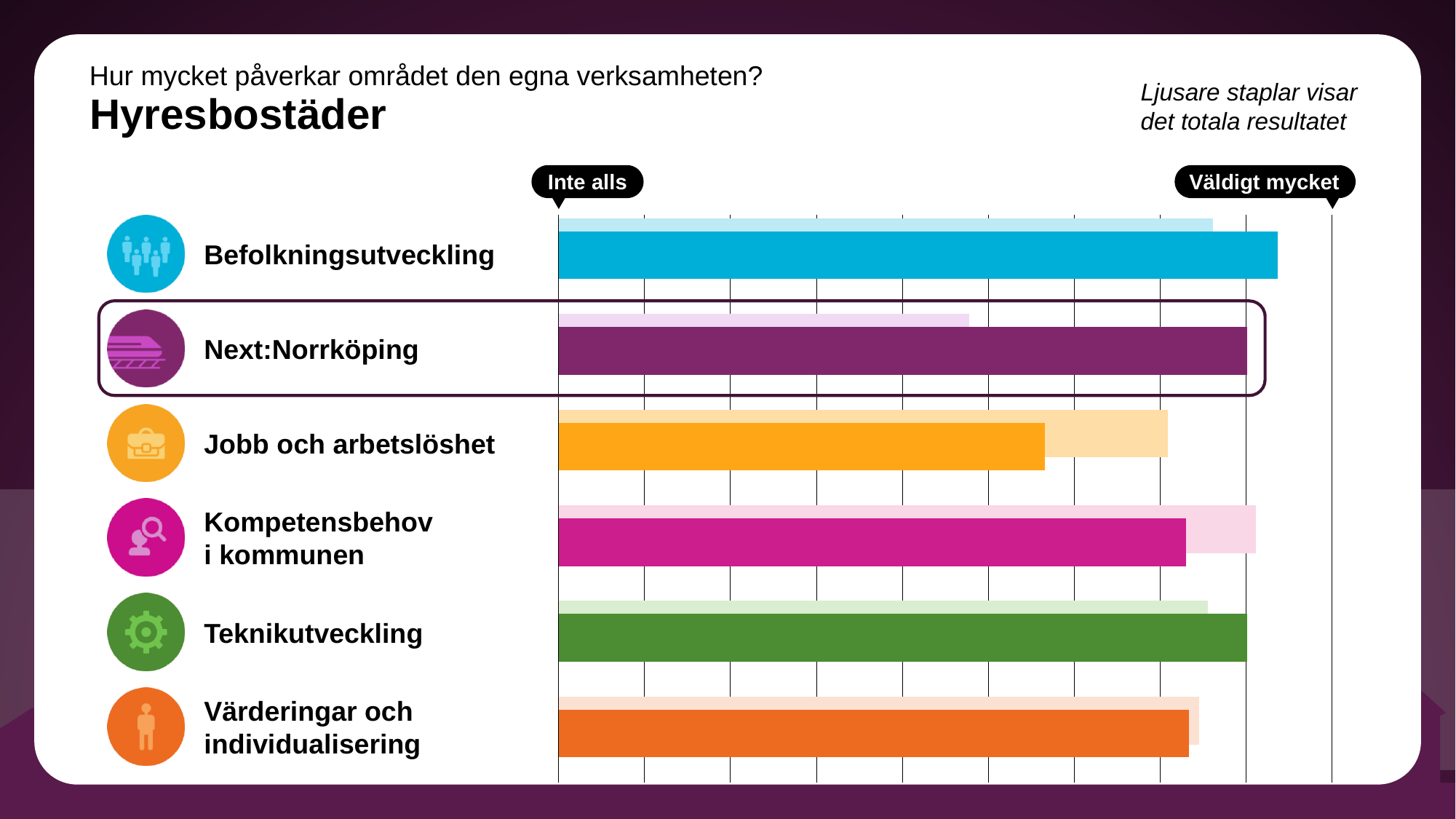
For Jobb och arbetslöshet, which bar is longer, the dark bar or the light bar? the light bar According to the note on the slide, what do the lighter bars show? det totala resultatet Which category has the shortest dark bar? Jobb och arbetslöshet Which dark bar is longer: Teknikutveckling or Värderingar och individualisering? Teknikutveckling How many categories (areas) are listed in the chart? 6 Which category has the longest light bar? Kompetensbehov i kommunen For Next:Norrköping, which bar is longer, the dark bar or the light bar? the dark bar What is the main title of the chart on the slide? Hyresbostäder What kind of chart is shown on the slide? bar chart Which category has the shortest light bar? Next:Norrköping Which category has the longest dark bar? Befolkningsutveckling